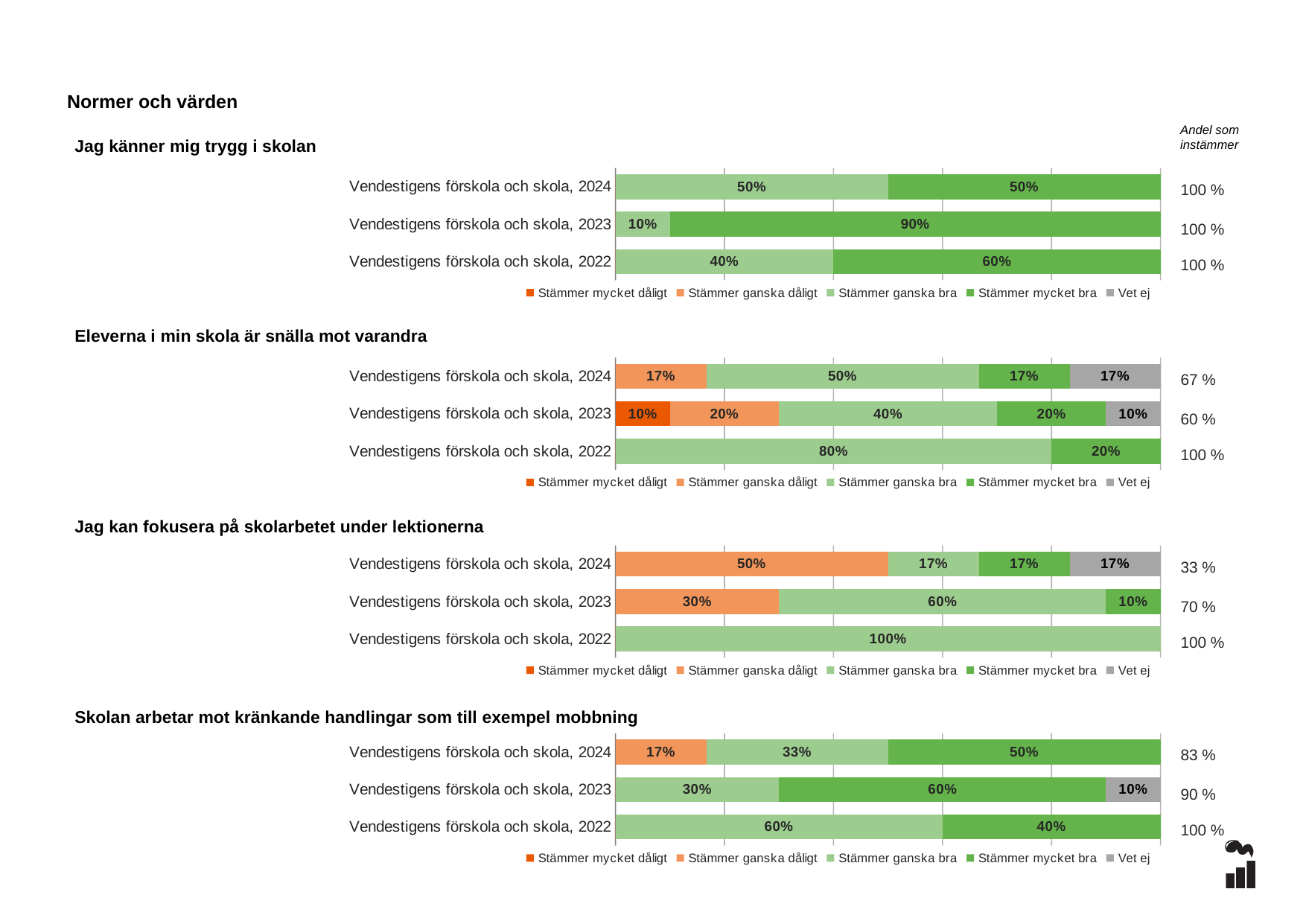
In the chart 'Skolan arbetar mot kränkande handlingar som till exempel mobbning', what is the total of the 2024 bar? 100% In the chart 'Eleverna i min skola är snälla mot varandra', what is the value for 'Stämmer mycket dåligt' for Vendestigens förskola och skola, 2023? 10% How many series does the legend list for the chart 'Jag känner mig trygg i skolan'? 5 In the chart 'Jag kan fokusera på skolarbetet under lektionerna', which year has the lowest 'Andel som instämmer'? Vendestigens förskola och skola, 2024 In the chart 'Skolan arbetar mot kränkande handlingar som till exempel mobbning', what is the difference between the 'Stämmer mycket bra' values for 2023 and 2022? 20% In the chart 'Eleverna i min skola är snälla mot varandra', what is the 'Andel som instämmer' for Vendestigens förskola och skola, 2024? 67 % In the chart 'Jag känner mig trygg i skolan', what is the value for 'Stämmer mycket bra' for Vendestigens förskola och skola, 2023? 90% How many bars are shown in the chart 'Eleverna i min skola är snälla mot varandra'? 3 In the chart 'Jag känner mig trygg i skolan', which year has the highest 'Stämmer mycket bra' share? Vendestigens förskola och skola, 2023 In the chart 'Skolan arbetar mot kränkande handlingar som till exempel mobbning', is the 'Stämmer ganska bra' value for 2022 larger than that for 2023? Yes, 2022 (60%) What kind of chart is 'Jag kan fokusera på skolarbetet under lektionerna'? Stacked bar chart In the chart 'Jag kan fokusera på skolarbetet under lektionerna', what is the value for 'Stämmer ganska dåligt' for Vendestigens förskola och skola, 2024? 50%